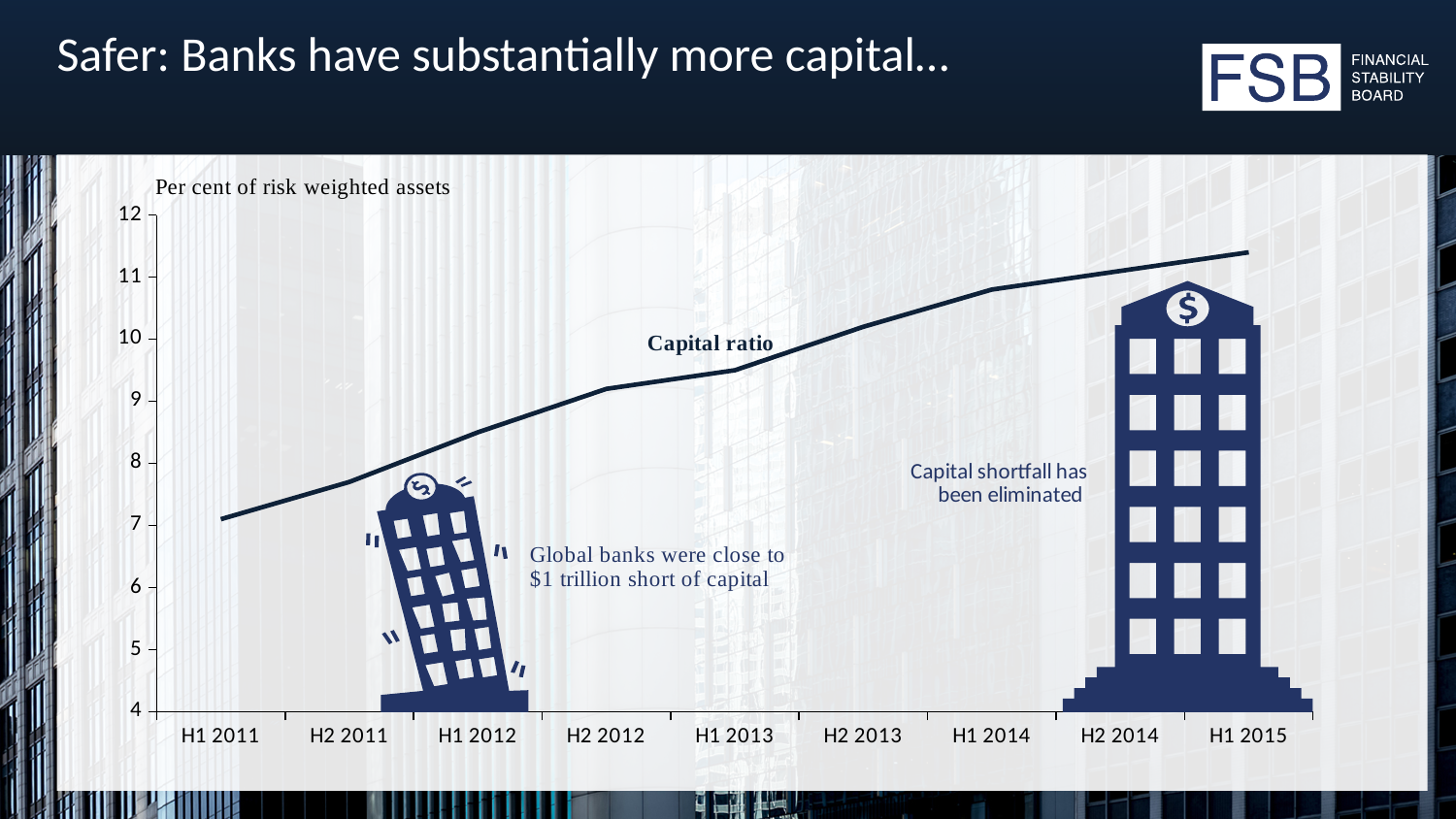
How many time periods are shown on the x axis? 9 Is the capital ratio for H1 2011 greater or less than 8? less Is the capital ratio for H1 2014 greater or less than 10? greater Is the capital ratio for H2 2012 greater or less than 9? greater What is the name of the line plotted on the chart? Capital ratio Which period has the highest capital ratio? H1 2015 What unit is the y axis measured in, according to the label above the chart? Per cent of risk weighted assets What kind of chart is shown on the slide? line chart Does the capital ratio rise or fall from H1 2011 to H1 2015? rise Which period has a higher capital ratio, H2 2011 or H2 2013? H2 2013 Which period has the lowest capital ratio? H1 2011